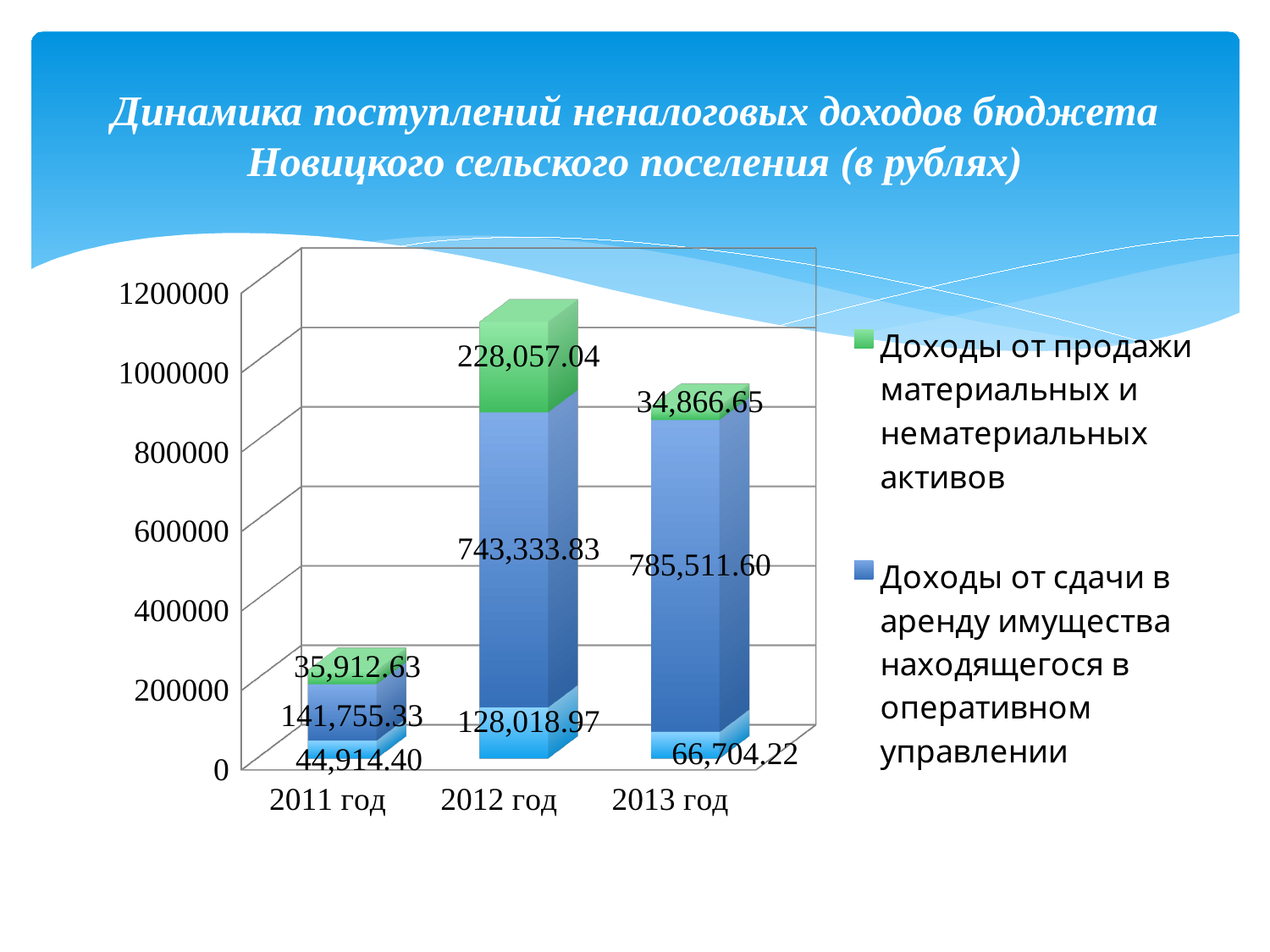
How many years are shown on the x axis? 3 What is the value of 'Доходы от продажи материальных и нематериальных активов' for 2012 год? 228,057.04 In which year is 'Доходы от продажи материальных и нематериальных активов' lowest? 2013 год How many series does the legend list? 2 What is the value of 'Доходы от продажи материальных и нематериальных активов' for 2013 год? 34,866.65 What is the difference in 'Доходы от сдачи в аренду имущества находящегося в оперативном управлении' between 2013 год and 2012 год? 42,177.77 What is the value of 'Доходы от сдачи в аренду имущества находящегося в оперативном управлении' for 2013 год? 785,511.60 In which year is 'Доходы от сдачи в аренду имущества находящегося в оперативном управлении' highest? 2013 год What is the value of 'Доходы от сдачи в аренду имущества находящегося в оперативном управлении' for 2011 год? 141,755.33 In 2012 год, which is larger: 'Доходы от продажи материальных и нематериальных активов' or 'Доходы от сдачи в аренду имущества находящегося в оперативном управлении'? Доходы от сдачи в аренду имущества находящегося в оперативном управлении What is the total of the stacked bar for 2011 год? 222,582.36 What kind of chart is shown on the slide? Stacked bar chart